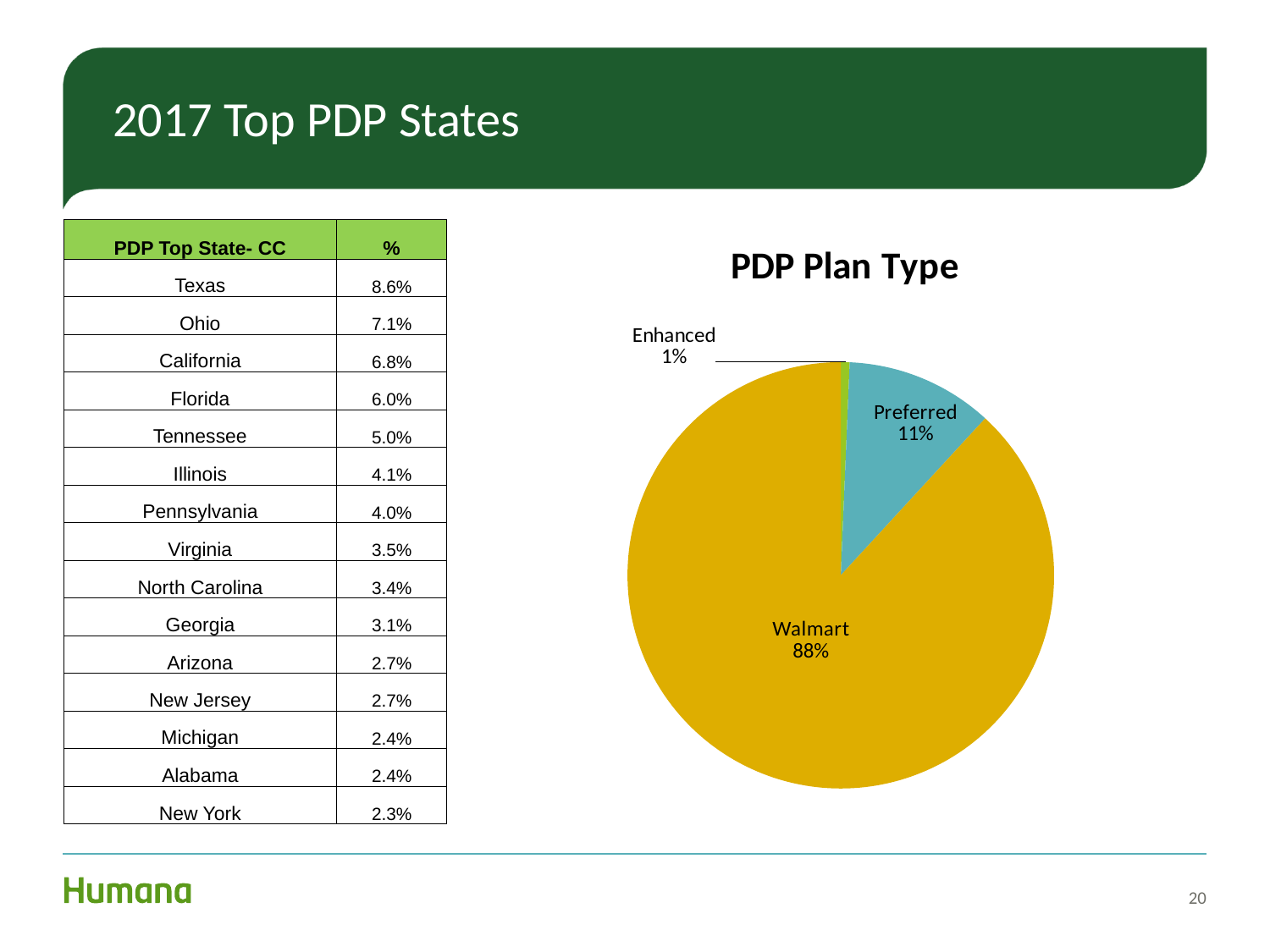
What kind of chart is shown on the slide? pie chart What is the title of the pie chart? PDP Plan Type What share of the pie does Enhanced have? 1% Which is larger, the Preferred slice or the Enhanced slice? Preferred Which plan type has the smallest slice of the pie? Enhanced What share of the pie does Preferred have? 11% What share of the pie does Walmart have? 88% What is the difference in percentage points between the Walmart and Preferred slices? 77 Which plan type has the largest slice of the pie? Walmart How many slices does the pie chart have? 3 What colour is the Walmart slice of the pie? yellow What is the difference in percentage points between the Preferred and Enhanced slices? 10